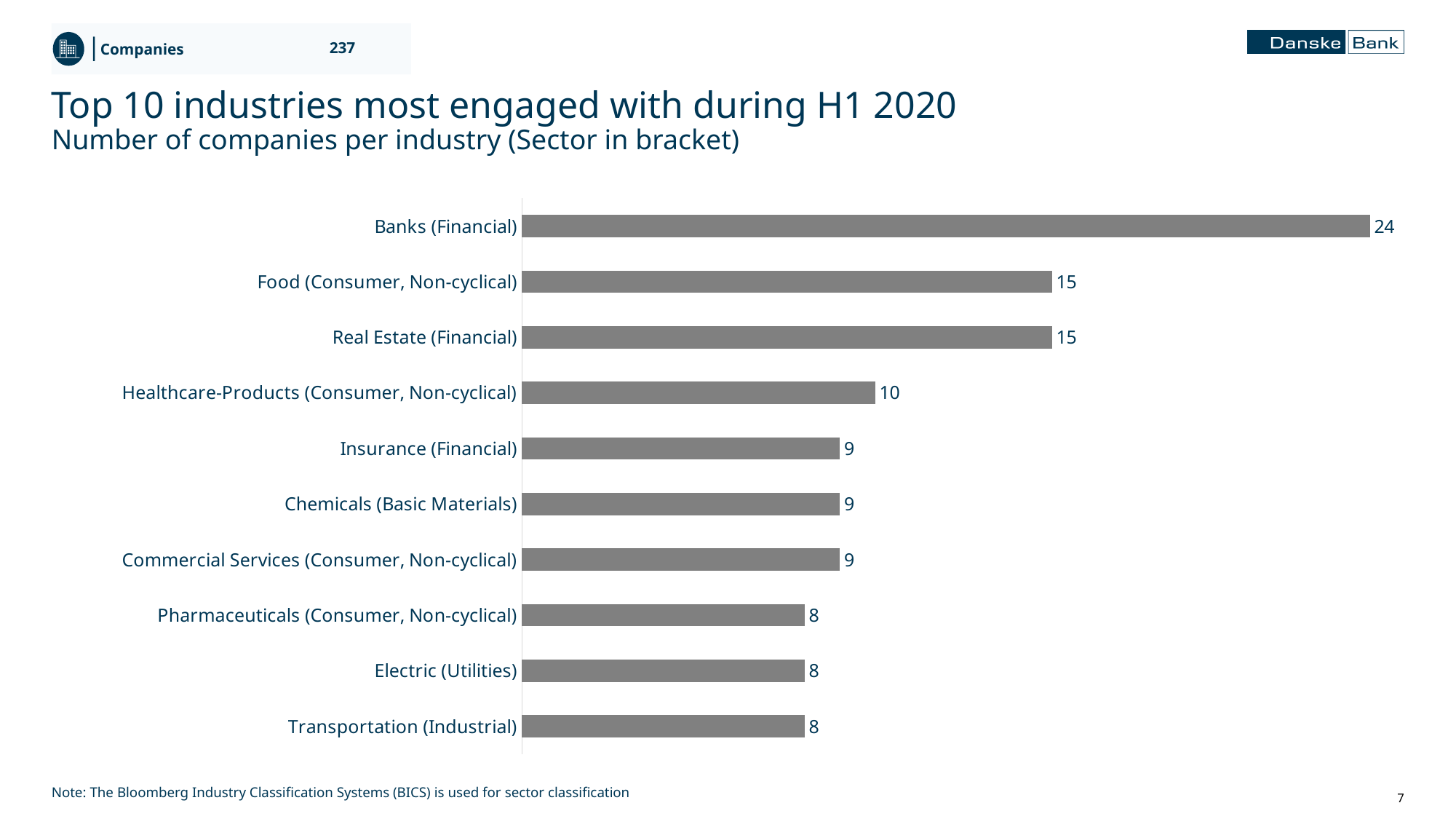
What is the value for Healthcare-Products (Consumer, Non-cyclical)? 10 What kind of chart is shown on the slide? Bar chart How many industries are shown in the chart? 10 What is the value for Chemicals (Basic Materials)? 9 Which is larger, the value for Healthcare-Products (Consumer, Non-cyclical) or Pharmaceuticals (Consumer, Non-cyclical)? Healthcare-Products (Consumer, Non-cyclical) What is the difference between the values for Real Estate (Financial) and Insurance (Financial)? 6 What is the value for Electric (Utilities)? 8 Which industry has the highest number of companies? Banks (Financial) How many industries have a value of 8? 3 What is the difference between the values for Banks (Financial) and Food (Consumer, Non-cyclical)? 9 How many companies are shown for Banks (Financial)? 24 What is the title of the chart? Top 10 industries most engaged with during H1 2020